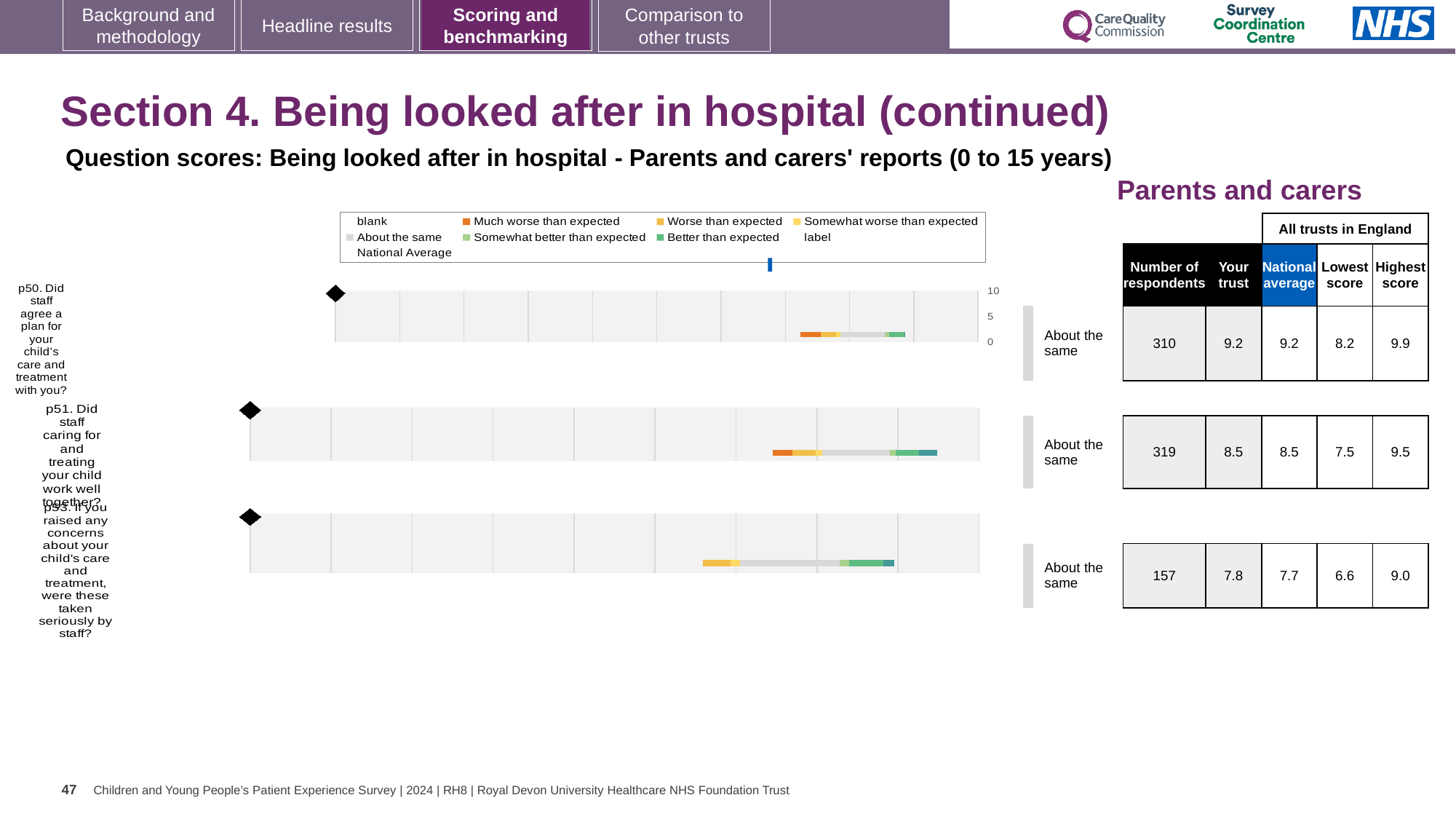
Which question has the lowest 'Your trust' score? p53 For question p50, what is the 'Your trust' score shown in the table? 9.2 What benchmark category is shown for question p50? About the same How many questions (p50, p51, p53) have benchmarking charts on this slide? 3 Which legend entry is shown in orange? Much worse than expected For question p53, which is larger: the 'Your trust' score or the national average? Your trust For question p51, how many respondents are shown? 319 What type of chart is used to show the benchmarking for each question on this slide? bar chart Which question has the highest number of respondents? p51 For question p53, what is the lowest score among all trusts in England? 6.6 For question p53, what is the difference between the highest score and the lowest score? 2.4 For question p53, what is the national average score? 7.7